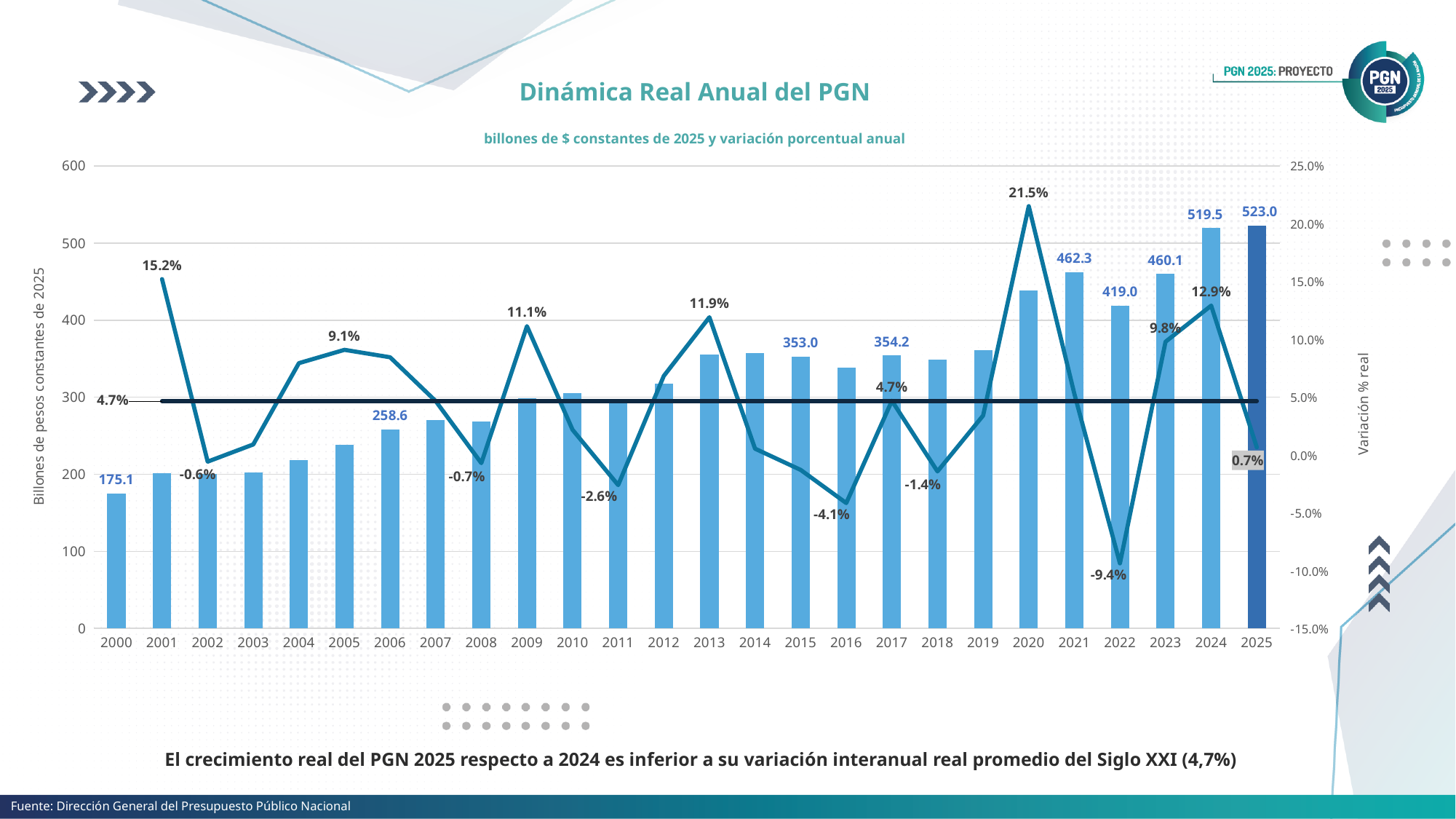
Is the PGN bar value for 2004 greater or less than 300? less What is the annual real variation shown for 2022? -9.4% Which year has the larger PGN bar value, 2021 or 2023? 2021 Which year has the highest PGN bar value? 2025 In which year does the variation line reach its lowest point? 2022 What is the annual real variation shown for 2020? 21.5% Which year has the lowest PGN bar value? 2000 What is the value of the PGN bar for 2025? 523.0 What value does the horizontal average line on the chart mark? 4.7% What is the value of the PGN bar for 2000? 175.1 What is the difference between the PGN bar values for 2025 and 2024? 3.5 How many years are shown on the x axis of the chart? 26